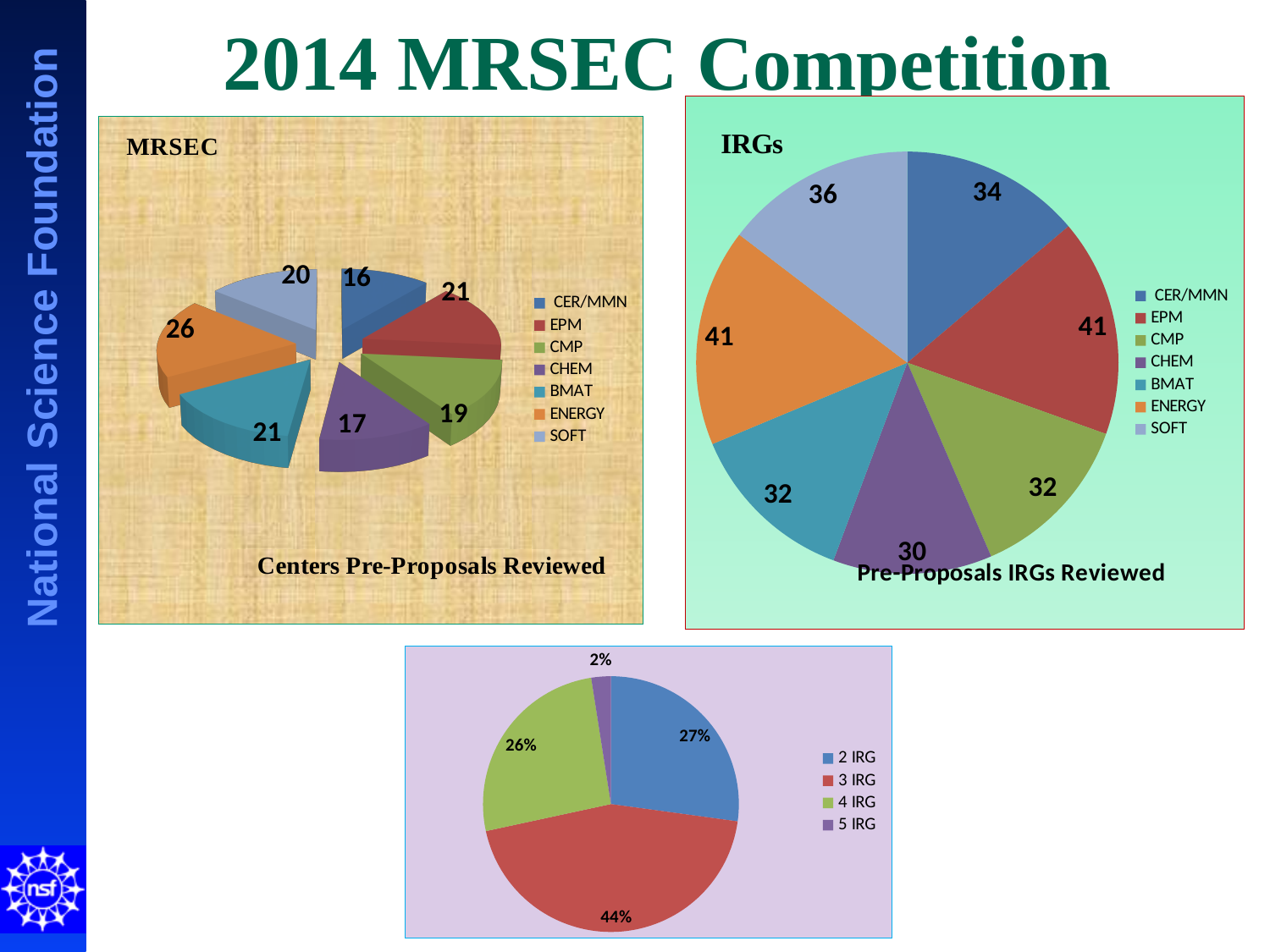
How many categories does the legend of the 'Pre-Proposals IRGs Reviewed' chart list? 7 In the bottom chart, what is the difference between the shares for 2 IRG and 4 IRG? 1% In the 'Pre-Proposals IRGs Reviewed' chart, which category has the lowest value? CHEM In the 'Centers Pre-Proposals Reviewed' chart, what is the difference between the values for ENERGY and CHEM? 9 In the 'Centers Pre-Proposals Reviewed' chart, which category has the lowest value? CER/MMN In the bottom chart, what share of the pie is 3 IRG? 44% In the 'Pre-Proposals IRGs Reviewed' chart, which is larger, the value for CER/MMN or the value for CMP? CER/MMN In the 'Centers Pre-Proposals Reviewed' chart, which category has the highest value? ENERGY In the bottom chart, which category has the smallest slice? 5 IRG What kind of chart is the bottom chart? Pie chart In the 'Pre-Proposals IRGs Reviewed' chart, what is the value for SOFT? 36 In the 'Centers Pre-Proposals Reviewed' chart, what is the value for ENERGY? 26